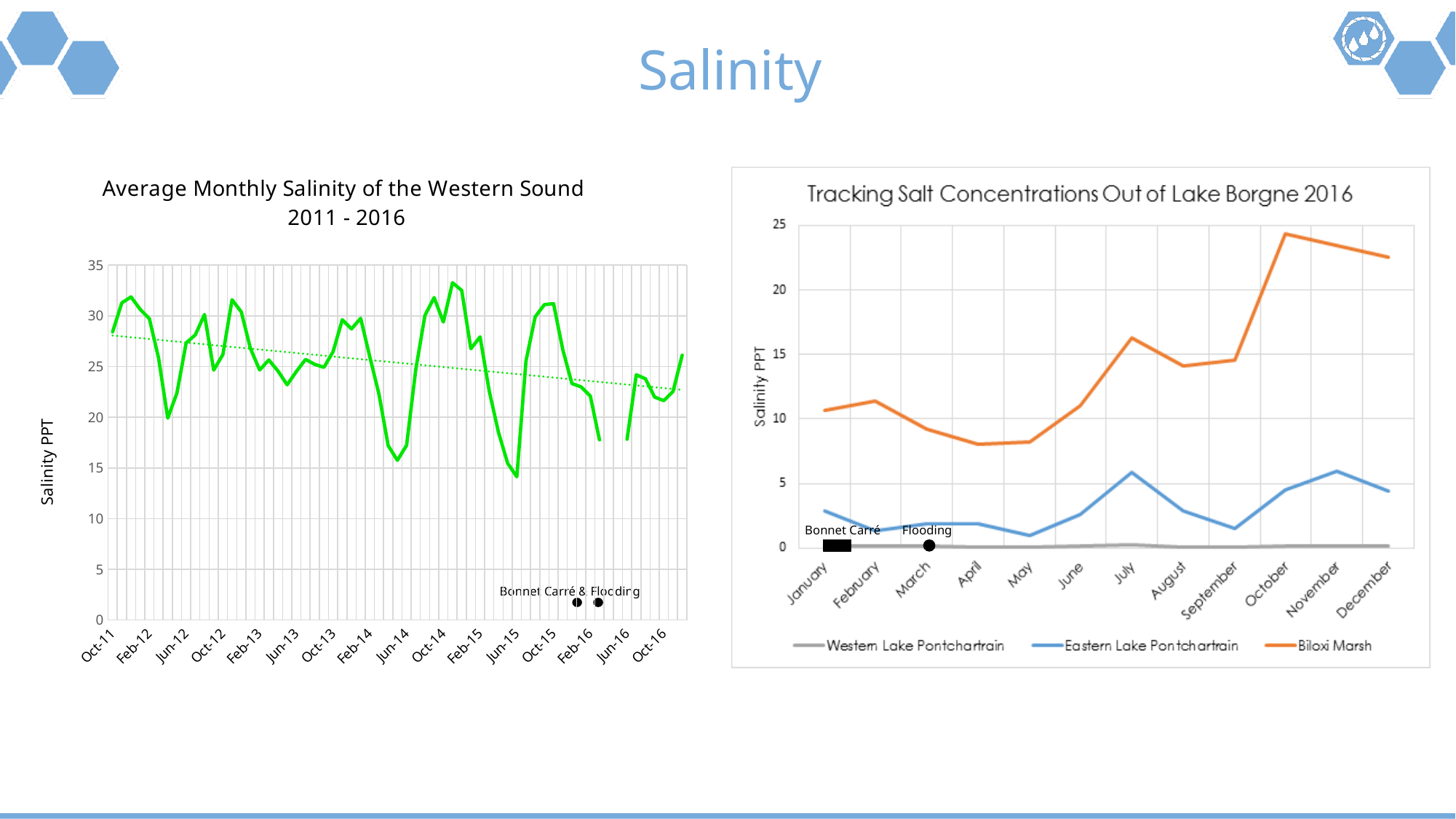
In 'Tracking Salt Concentrations Out of Lake Borgne 2016', in which month is the Biloxi Marsh value highest? October In 'Tracking Salt Concentrations Out of Lake Borgne 2016', is the Biloxi Marsh value for April greater or less than 10? less In 'Tracking Salt Concentrations Out of Lake Borgne 2016', is the Biloxi Marsh value for October greater or less than 20? greater What type of chart is 'Average Monthly Salinity of the Western Sound 2011 - 2016'? line chart In 'Tracking Salt Concentrations Out of Lake Borgne 2016', how many months are shown on the x axis? 12 In 'Tracking Salt Concentrations Out of Lake Borgne 2016', which series has the lowest values throughout the year? Western Lake Pontchartrain In 'Tracking Salt Concentrations Out of Lake Borgne 2016', is the Eastern Lake Pontchartrain value for May greater or less than 5? less What type of chart is 'Tracking Salt Concentrations Out of Lake Borgne 2016'? line chart In 'Tracking Salt Concentrations Out of Lake Borgne 2016', how many series does the legend list? 3 In 'Average Monthly Salinity of the Western Sound 2011 - 2016', does the dotted trend line rise or fall from left to right? fall In 'Tracking Salt Concentrations Out of Lake Borgne 2016', which is larger in October: Biloxi Marsh or Eastern Lake Pontchartrain? Biloxi Marsh